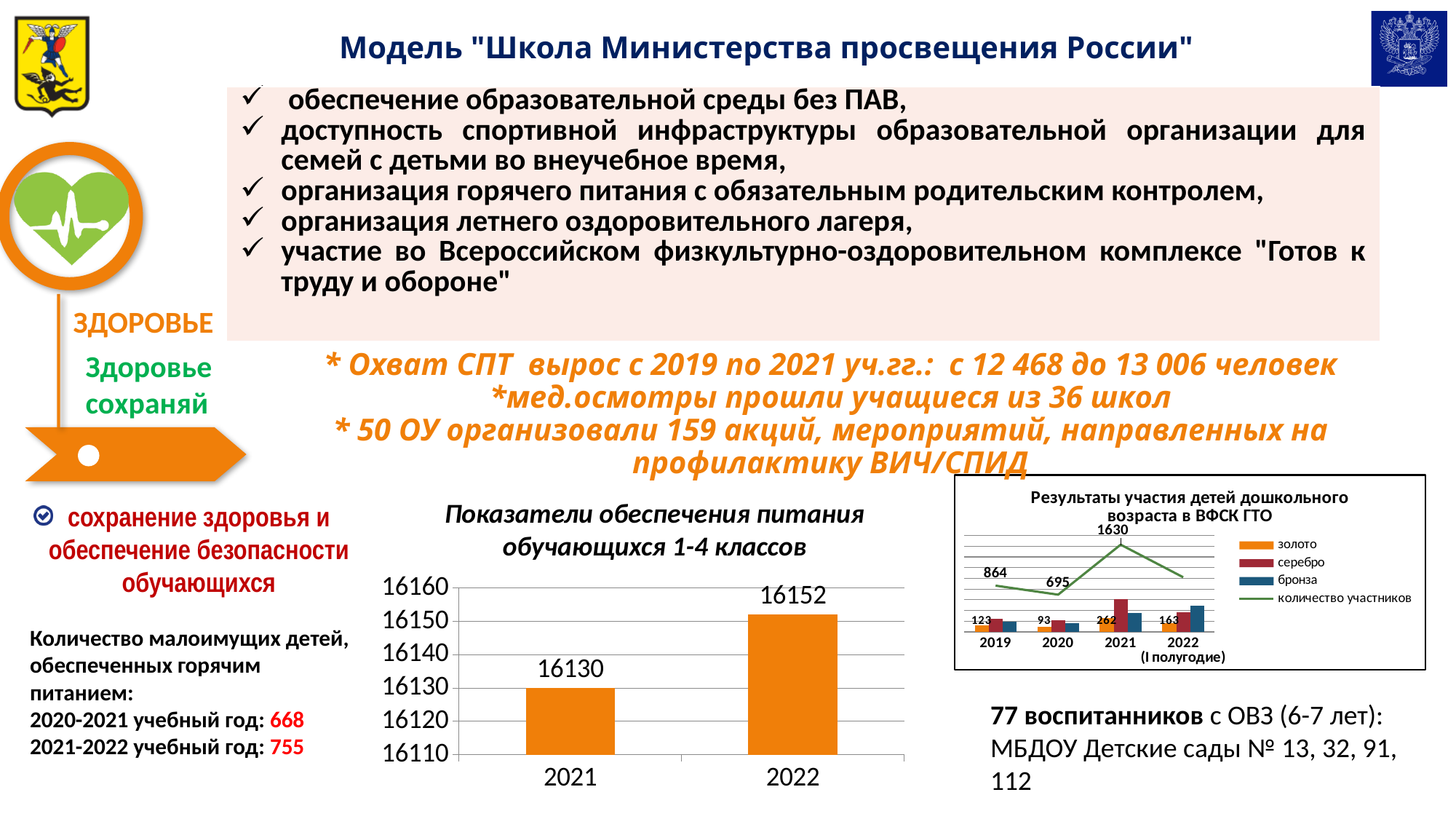
What kind of chart is "Показатели обеспечения питания обучающихся 1-4 классов"? bar chart On the chart "Результаты участия детей дошкольного возраста в ВФСК ГТО", what is the value of количество участников for 2019? 864 On the chart "Результаты участия детей дошкольного возраста в ВФСК ГТО", how many series does the legend list? 4 On the chart "Результаты участия детей дошкольного возраста в ВФСК ГТО", which year has the lowest value of золото? 2020 On the chart "Результаты участия детей дошкольного возраста в ВФСК ГТО", what is the difference in количество участников between 2019 and 2020? 169 On the chart "Показатели обеспечения питания обучающихся 1-4 классов", by how much does the 2022 value exceed the 2021 value? 22 On the chart "Показатели обеспечения питания обучающихся 1-4 классов", what is the value for 2022? 16152 On the chart "Результаты участия детей дошкольного возраста в ВФСК ГТО", what is the value of золото for 2021? 262 On the chart "Результаты участия детей дошкольного возраста в ВФСК ГТО", what is the value of количество участников for 2021? 1630 On the chart "Показатели обеспечения питания обучающихся 1-4 классов", what is the value for 2021? 16130 On the chart "Показатели обеспечения питания обучающихся 1-4 классов", how many categories are shown on the x axis? 2 On the chart "Показатели обеспечения питания обучающихся 1-4 классов", which year has the higher value? 2022